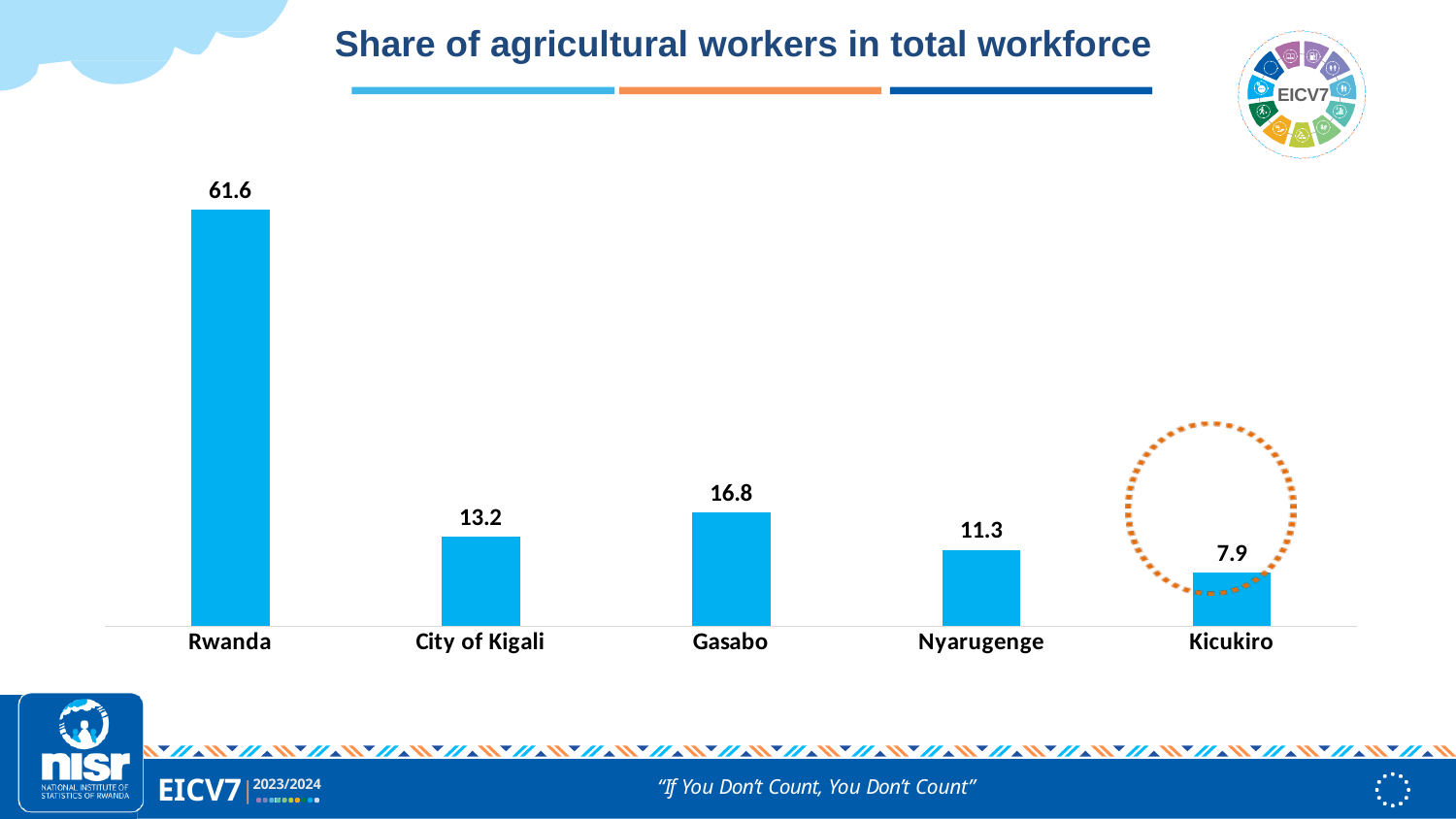
Which category has the highest share of agricultural workers? Rwanda What is the value shown for Gasabo? 16.8 How many categories are shown on the chart? 5 What is the share of agricultural workers in total workforce for Rwanda? 61.6 Which category has the lowest share of agricultural workers? Kicukiro What is the value shown for Nyarugenge? 11.3 Which has a larger value, Gasabo or Nyarugenge? Gasabo What is the difference between the values for Gasabo and Kicukiro? 8.9 What is the difference between the values for Rwanda and City of Kigali? 48.4 What is the value shown for Kicukiro? 7.9 What kind of chart is shown on the slide? Bar chart What is the value shown for City of Kigali? 13.2